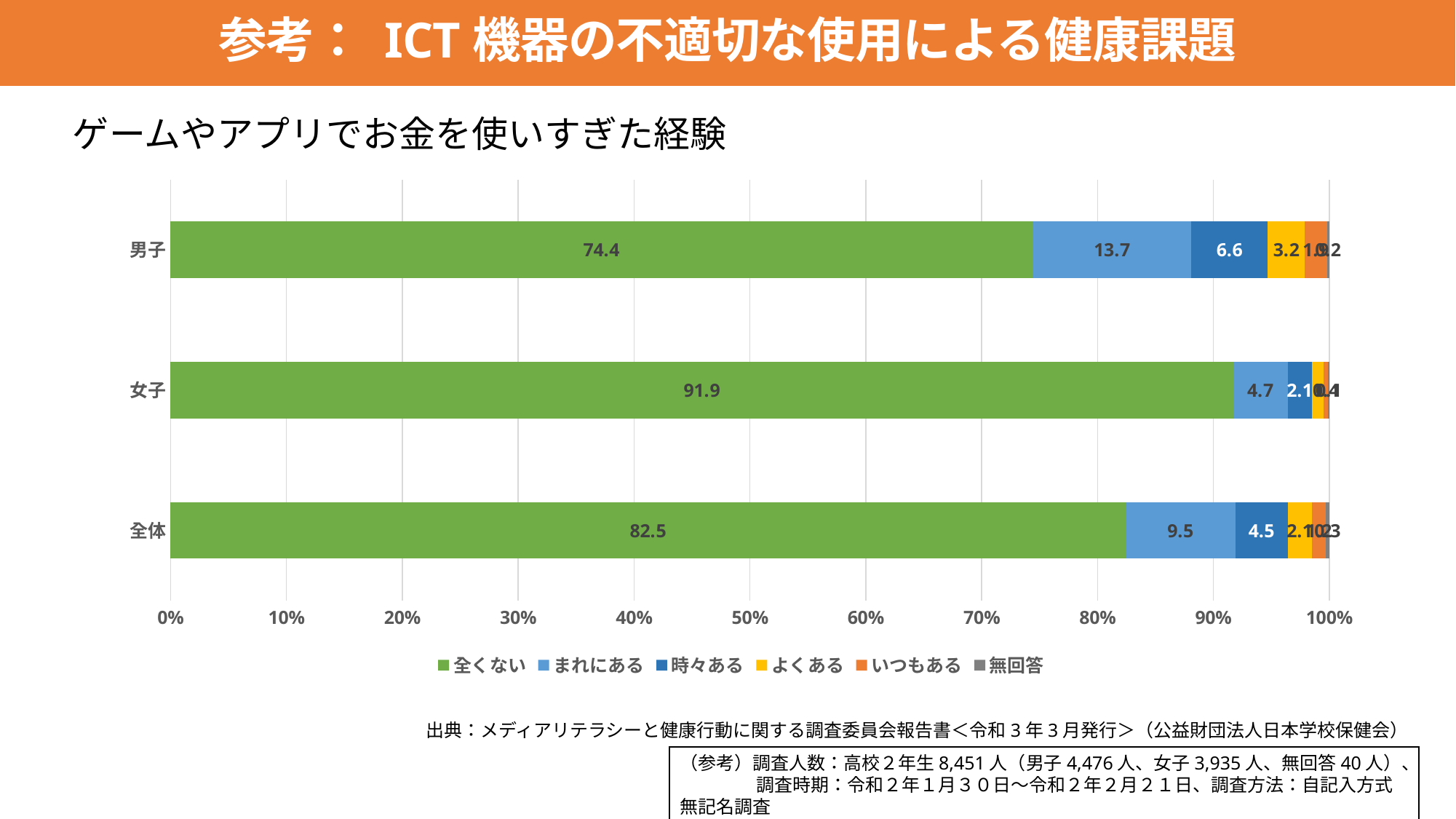
What is the value of まれにある for 全体? 9.5 What kind of chart is shown on the slide? Stacked bar chart What is the value of 全くない for 男子? 74.4 How many series does the legend list? 6 Which category has the highest value for 全くない? 女子 Which has the larger value for まれにある, 男子 or 女子? 男子 What is the title of the chart? ゲームやアプリでお金を使いすぎた経験 What is the value of 全くない for 女子? 91.9 Which category has the lowest value for 全くない? 男子 How many categories are shown on the chart? 3 What is the difference between the 全くない values for 女子 and 男子? 17.5 What is the value of 時々ある for 男子? 6.6